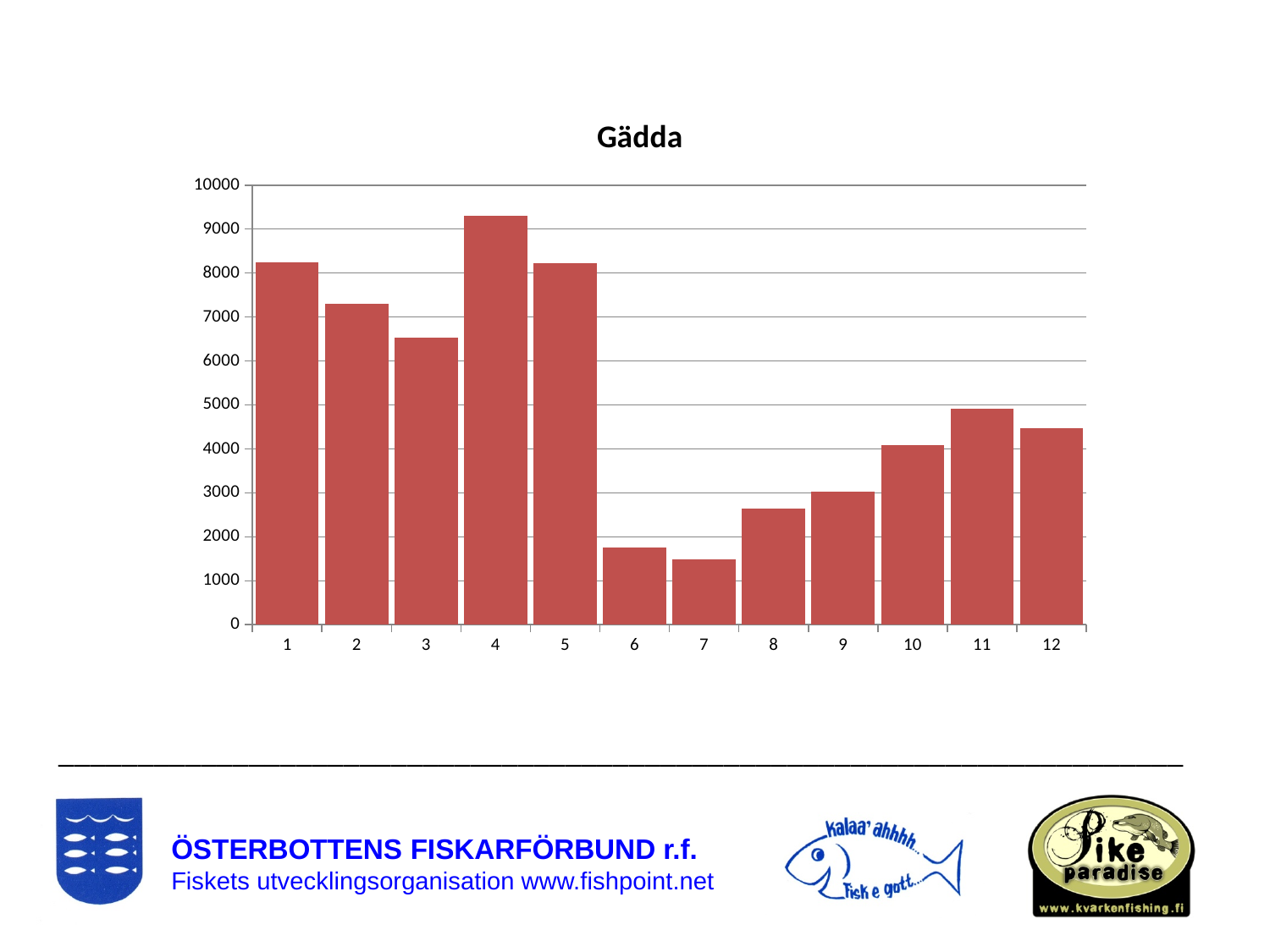
Which has the larger value, category 11 or category 12? 11 Do the values rise or fall from category 7 to category 11? rise Is the value for category 3 greater or less than 7000? less Which has the larger value, category 2 or category 3? 2 Which category has the highest bar in the chart? 4 Is the value for category 11 greater or less than 4000? greater Is the value for category 7 greater or less than 2000? less How many categories are shown on the x axis of the chart? 12 What is the title of the chart? Gädda Which category has the lowest bar in the chart? 7 What kind of chart is shown on the slide? bar chart